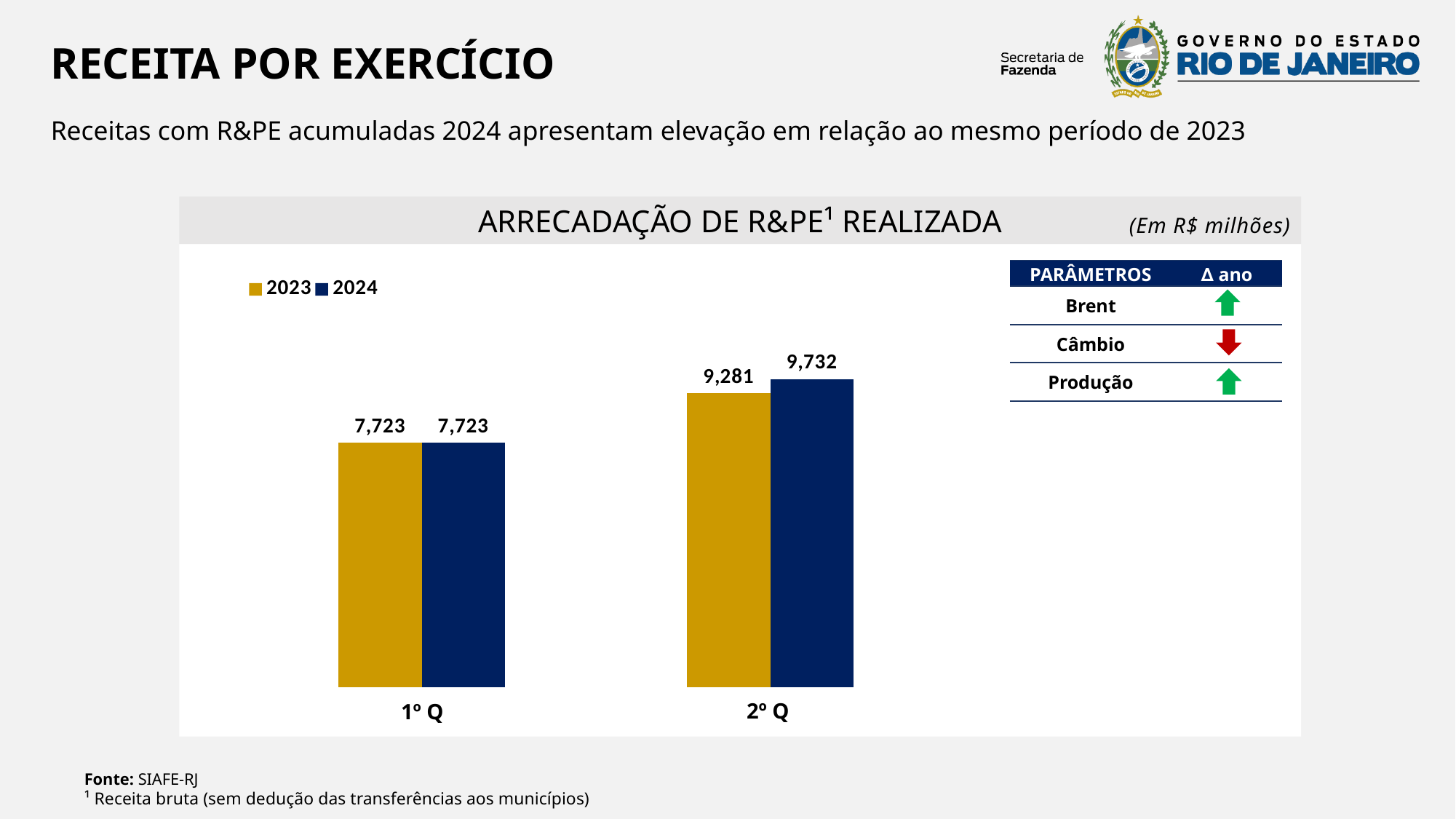
How many quarters are shown on the x axis? 2 Which quarter has the highest value for the 2024 series? 2º Q What is the value for 2023 in 2º Q? 9,281 How many series does the legend list? 2 What is the difference between the 2024 and 2023 values in 2º Q? 451 What is the value for 2023 in 1º Q? 7,723 What kind of chart is shown? Bar chart In 2º Q, which series has the larger value, 2023 or 2024? 2024 Which quarter has the lowest value for the 2023 series? 1º Q What is the title of the chart? ARRECADAÇÃO DE R&PE¹ REALIZADA What is the value for 2024 in 2º Q? 9,732 What is the value for 2024 in 1º Q? 7,723